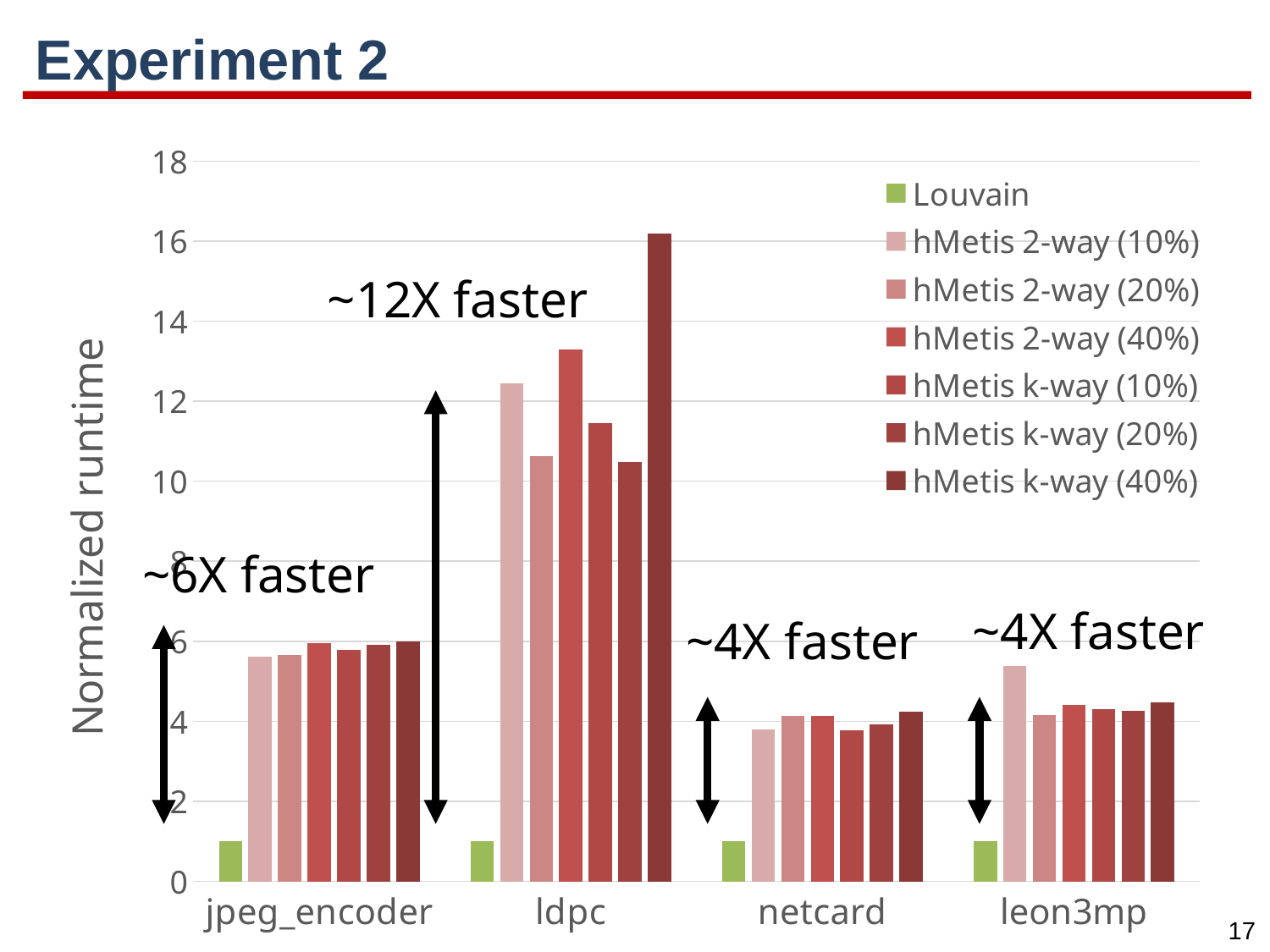
Is the hMetis 2-way (10%) value for jpeg_encoder greater or less than 6? less Is the Louvain value for netcard greater or less than 2? less Is the hMetis 2-way (10%) value for ldpc greater or less than 12? greater Which category has the highest hMetis k-way (40%) bar? ldpc Which is larger for ldpc: the hMetis 2-way (40%) value or the hMetis k-way (20%) value? hMetis 2-way (40%) Which series is shown in green in the chart's legend? Louvain What kind of chart is shown on the slide? bar chart How many categories are shown on the x axis of the chart? 4 How many series does the chart's legend list? 7 What is the label of the y axis of the chart? Normalized runtime